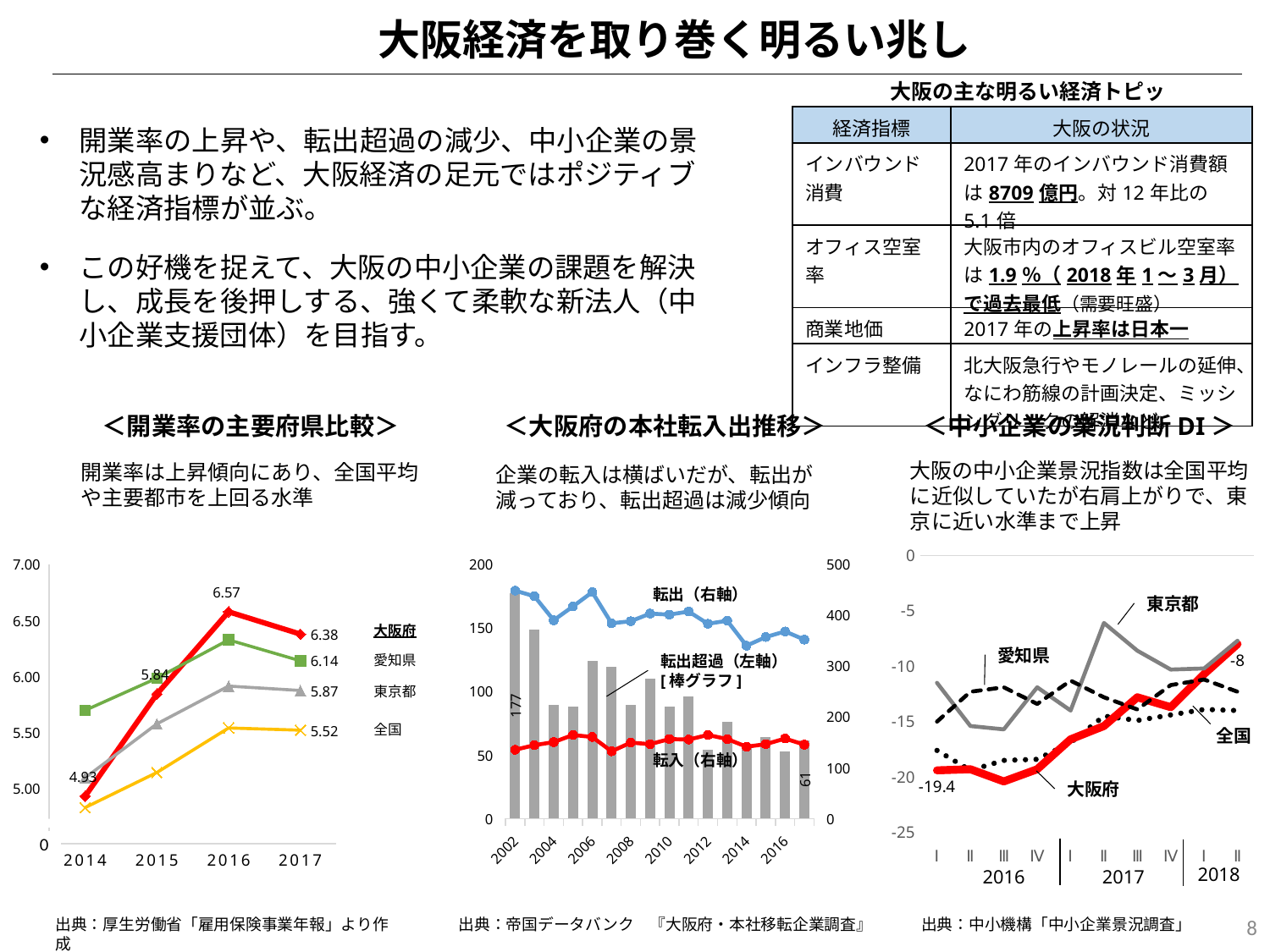
In the 大阪府の本社転入出推移 chart, do the 転出超過 bars generally rise or fall from 2002 onward? Fall In the 開業率の主要府県比較 chart, which series has the lowest value in 2017? 全国 What kind of chart is the 開業率の主要府県比較 chart? Line chart In the 開業率の主要府県比較 chart, how many series are plotted? 4 In the 大阪府の本社転入出推移 chart, what is the value of the 転出超過 bar for 2002? 177 In the 開業率の主要府県比較 chart, what is the value for 大阪府 in 2014? 4.93 In the 開業率の主要府県比較 chart, what is the value for 大阪府 in 2016? 6.57 In the 開業率の主要府県比較 chart, what is the difference between the 大阪府 values for 2016 and 2017? 0.19 In the 開業率の主要府県比較 chart, what is the value for 全国 in 2017? 5.52 In the 開業率の主要府県比較 chart, which series has the highest value in 2017? 大阪府 In the 大阪府の本社転入出推移 chart, what is the value of the rightmost 転出超過 bar? 61 In the 中小企業の業況判断DI chart, what is the value for 大阪府 in 2016 I? -19.4